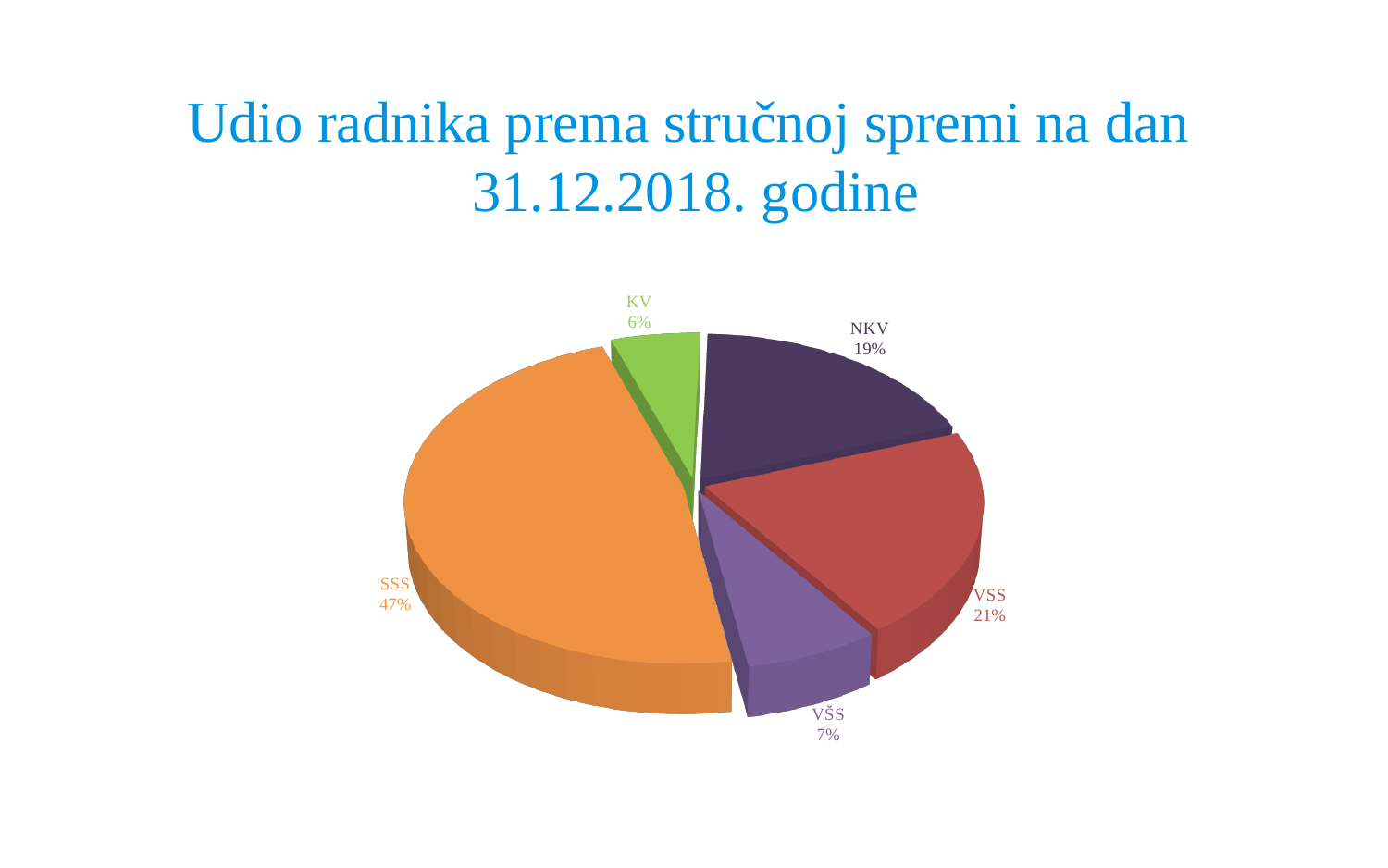
What kind of chart is shown on the slide? Pie chart What is the value shown for VSS? 21% What is the value shown for KV? 6% What is the value shown for NKV? 19% Which category has the largest slice of the pie? SSS What is the difference between the shares of VSS and NKV? 2% How many categories are shown in the pie chart? 5 What is the value shown for VŠS? 7% Which is larger, the share of NKV or the share of VŠS? NKV Which category has the smallest slice of the pie? KV What share of the pie does SSS have? 47% What is the title of the chart? Udio radnika prema stručnoj spremi na dan 31.12.2018. godine